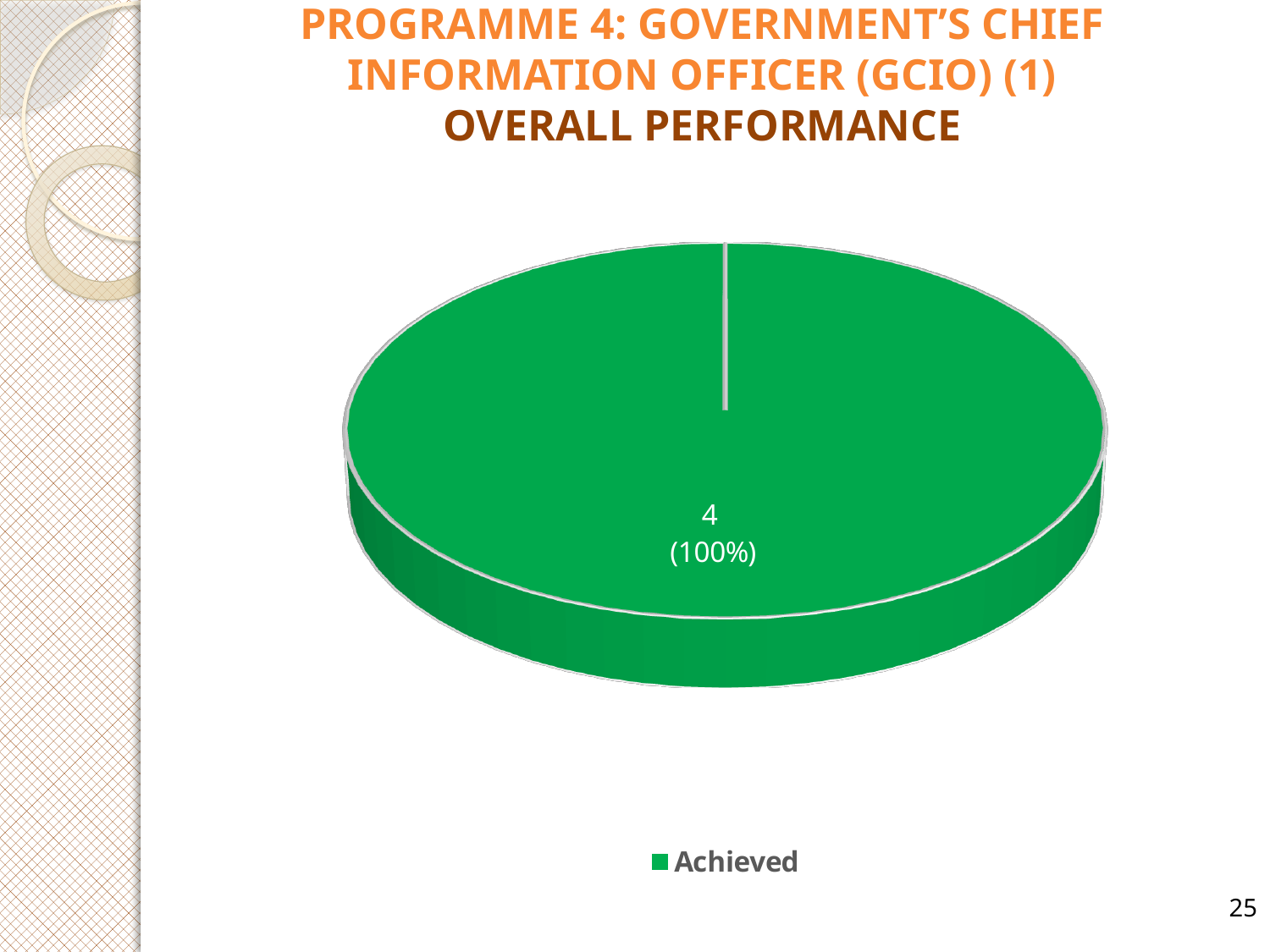
How many entries does the legend list? 1 What colour is the Achieved slice? green How many slices does the pie chart have? 1 What kind of chart is shown on the slide? pie chart What is the legend entry for the pie chart? Achieved What percentage share of the pie does the Achieved slice represent? 100% What is the value shown for the Achieved slice? 4